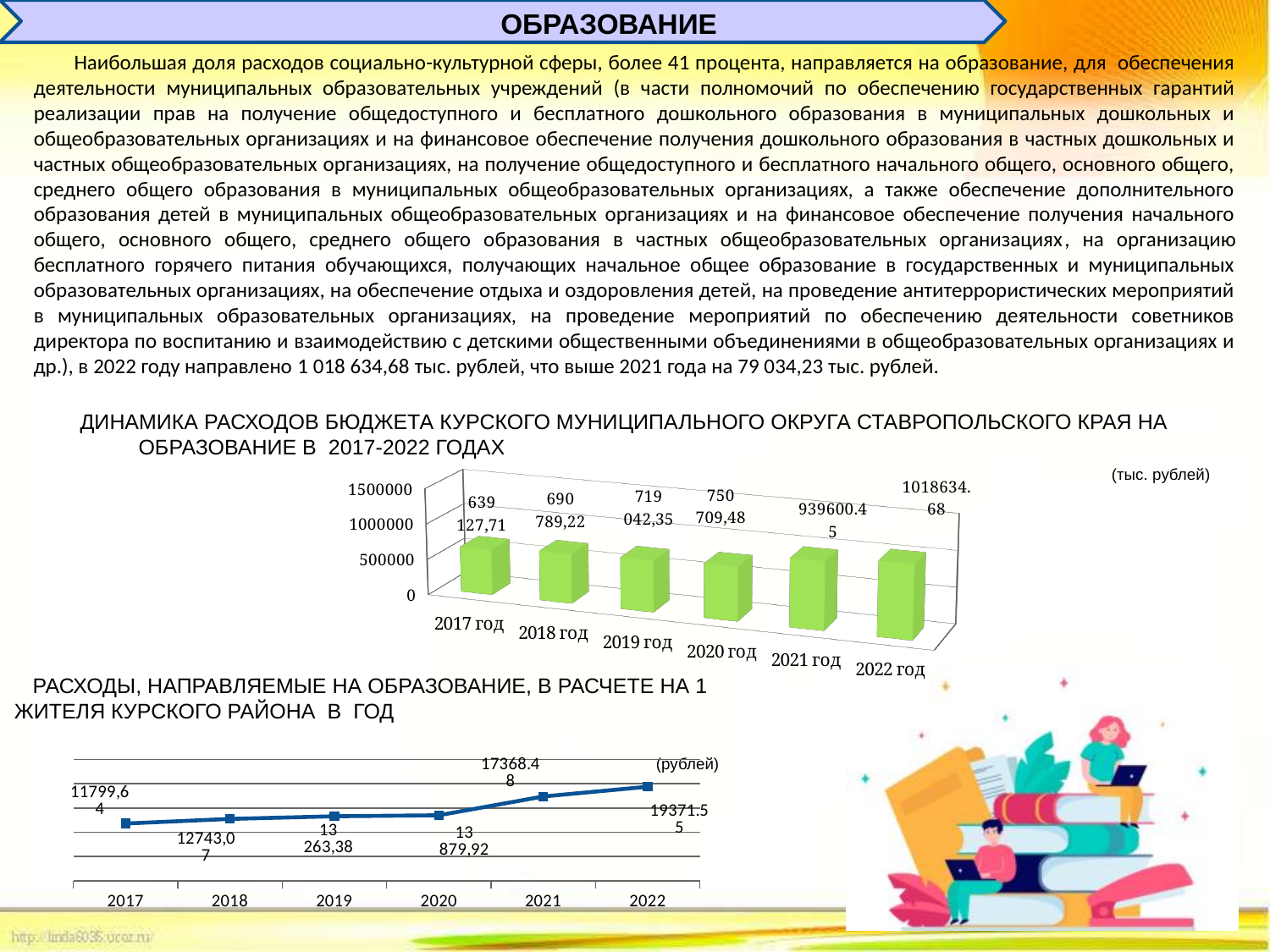
In the line chart 'Расходы, направляемые на образование, в расчете на 1 жителя Курского района в год', what is the value for 2019? 13 263,38 In the bar chart 'Динамика расходов бюджета ... на образование в 2017-2022 годах', what is the value for 2017 год? 639 127,71 What kind of chart is the upper chart 'Динамика расходов бюджета ... на образование в 2017-2022 годах'? bar chart In the bar chart 'Динамика расходов бюджета ... на образование в 2017-2022 годах', what is the difference between the values for 2022 год and 2021 год? 79034.23 In the bar chart 'Динамика расходов бюджета ... на образование в 2017-2022 годах', how many years are shown? 6 In the bar chart 'Динамика расходов бюджета ... на образование в 2017-2022 годах', which year has the lowest value? 2017 год In the bar chart 'Динамика расходов бюджета ... на образование в 2017-2022 годах', what is the value for 2022 год? 1018634.68 In the line chart 'Расходы, направляемые на образование, в расчете на 1 жителя Курского района в год', what is the value for 2022? 19371.55 In the line chart 'Расходы, направляемые на образование, в расчете на 1 жителя Курского района в год', which is larger, the value for 2018 or the value for 2021? 2021 In the bar chart 'Динамика расходов бюджета ... на образование в 2017-2022 годах', which year has the highest value? 2022 год In the bar chart 'Динамика расходов бюджета ... на образование в 2017-2022 годах', do the values rise or fall from 2017 to 2022? rise In the bar chart 'Динамика расходов бюджета ... на образование в 2017-2022 годах', what is the value for 2020 год? 750 709,48